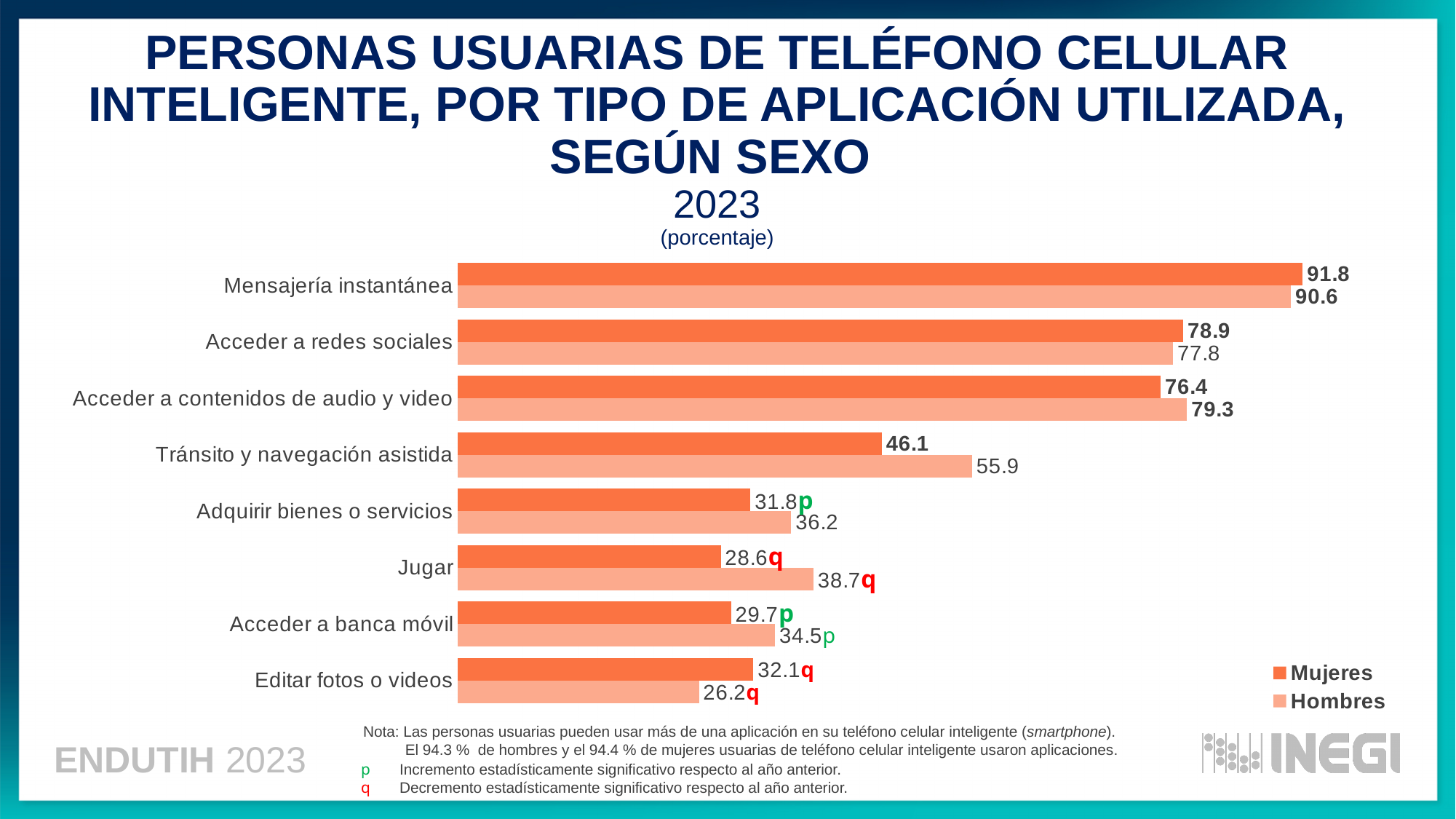
How many application categories are shown in the chart? 8 Which category has the lowest value for Hombres? Editar fotos o videos What is the value for Hombres in the Editar fotos o videos category? 26.2 What are the two series named in the legend? Mujeres and Hombres How many series does the legend list? 2 What is the value for Mujeres in the Mensajería instantánea category? 91.8 What is the value for Hombres in the Tránsito y navegación asistida category? 55.9 What is the difference between the Hombres and Mujeres values for Tránsito y navegación asistida? 9.8 Which category has the highest value for Mujeres? Mensajería instantánea What kind of chart is shown on the slide? Bar chart Which is larger for Acceder a contenidos de audio y video, the Mujeres value or the Hombres value? Hombres Which is larger for Jugar, the Mujeres value or the Hombres value? Hombres